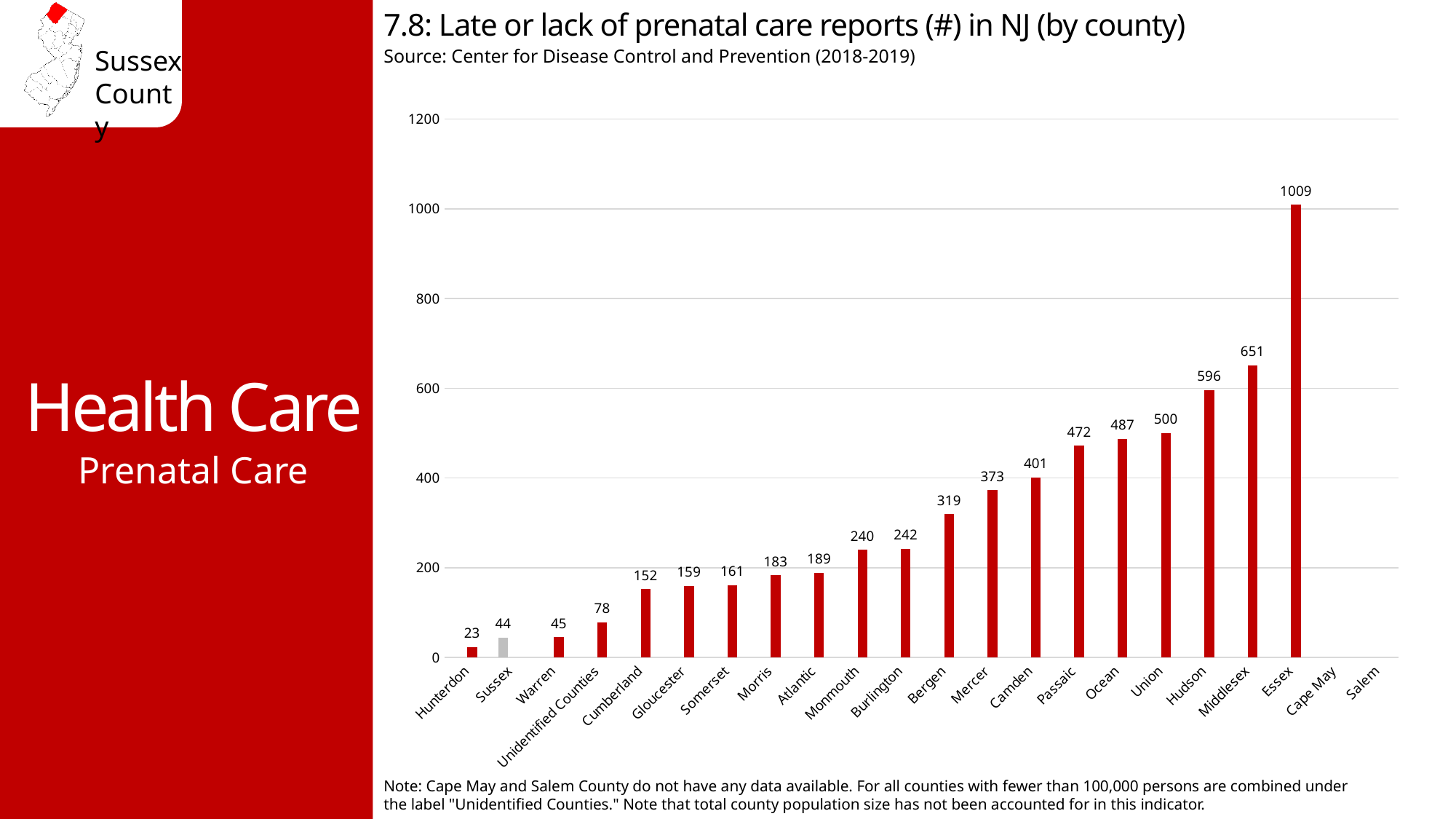
Do the plotted values generally rise or fall from left to right along the x axis? Rise How many county labels are shown on the x axis of the chart? 22 What is the value for Union in the chart? 500 Which county has the highest number of late or lack of prenatal care reports? Essex Which county has the lowest plotted value in the chart? Hunterdon Which has a larger value, Passaic or Ocean? Ocean What is the value for Essex in the chart? 1009 What is the difference between the values for Essex and Middlesex? 358 What kind of chart is shown on the slide? Bar chart What is the difference between the values for Warren and Sussex? 1 Which county's bar is coloured grey instead of red? Sussex What is the value for Sussex in the chart? 44